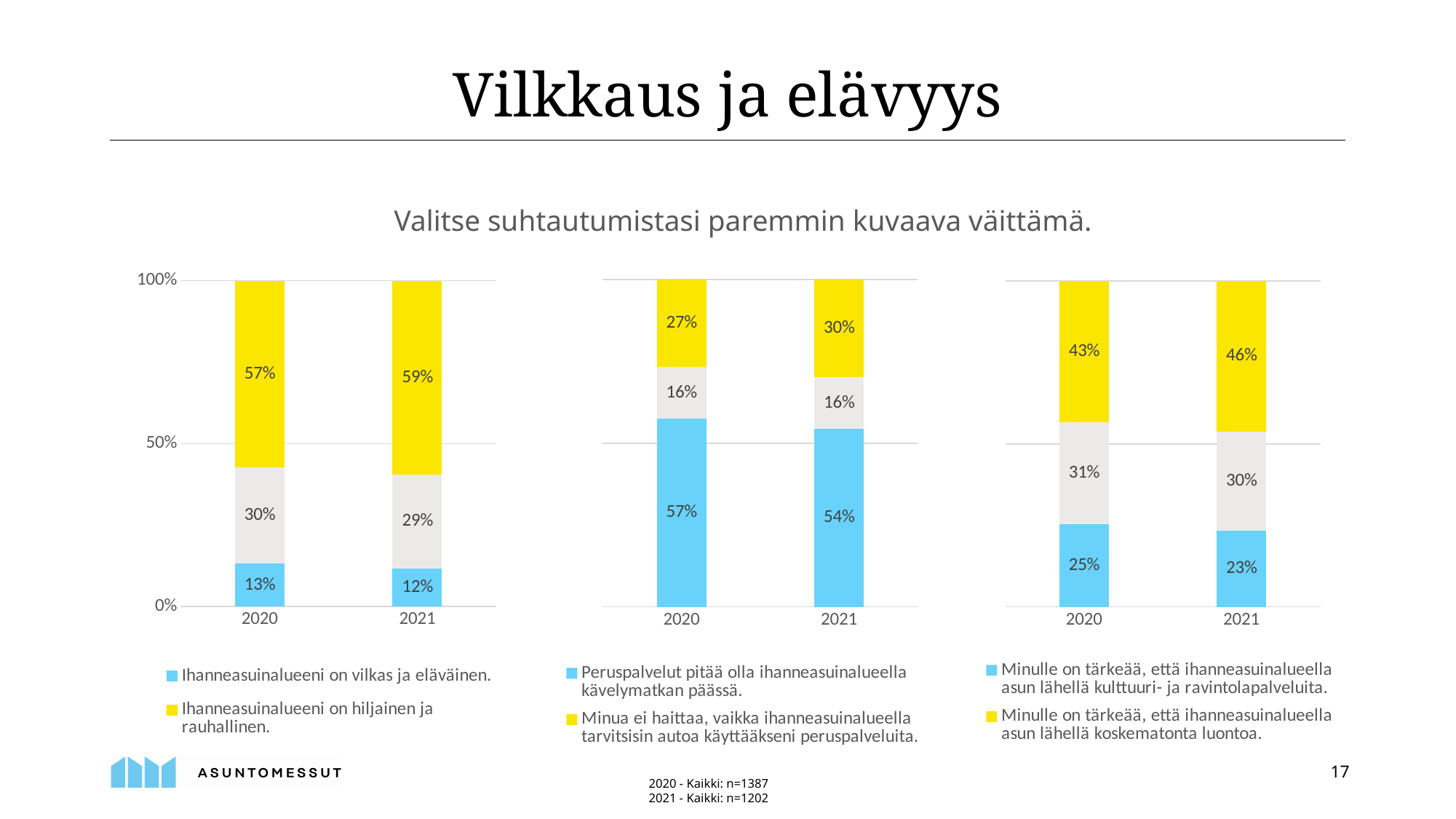
In the left chart, what is the value of the yellow segment ("Ihanneasuinalueeni on hiljainen ja rauhallinen.") for 2021? 59% How many categories are shown on the x axis of the middle chart? 2 What kind of chart is the right chart? stacked bar chart In the right chart, what is the value of the yellow segment ("Minulle on tärkeää, että ihanneasuinalueella asun lähellä koskematonta luontoa.") for 2020? 43% In the left chart, what is the value of the blue segment ("Ihanneasuinalueeni on vilkas ja eläväinen.") for 2020? 13% In the right chart, does the yellow segment value rise or fall from 2020 to 2021? rise How many series does the legend of the left chart list? 2 In the left chart, does the blue segment value rise or fall from 2020 to 2021? fall In the middle chart, what is the value of the blue segment ("Peruspalvelut pitää olla ihanneasuinalueella kävelymatkan päässä.") for 2021? 54% In the middle chart, what is the difference between the yellow segment values for 2021 and 2020? 3 percentage points In the middle chart, what is the value of the grey segment for 2020? 16% In the right chart, which year has the larger blue segment, 2020 or 2021? 2020